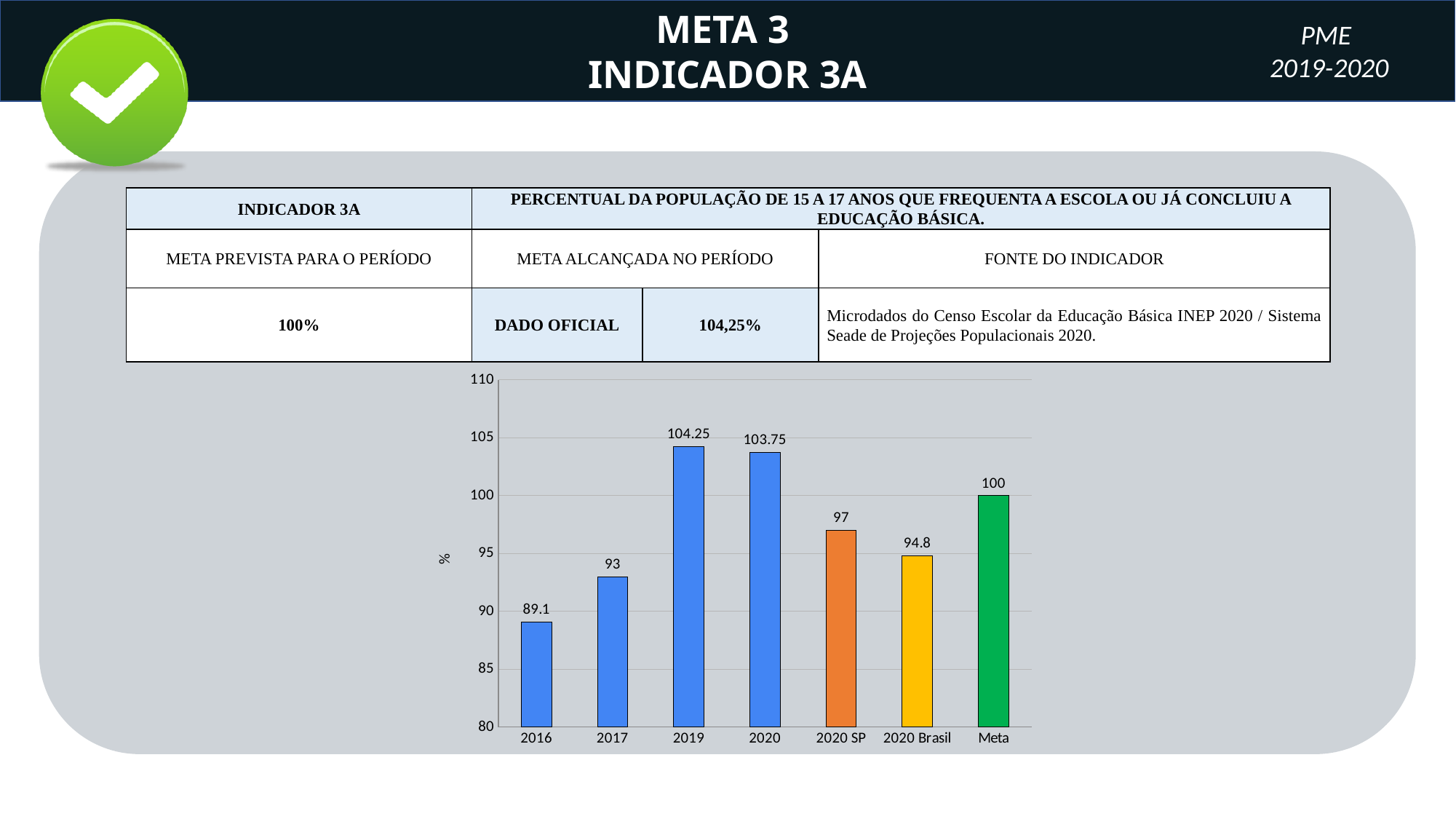
What is the value for 2019 in the bar chart? 104.25 How many bars are shown in the chart? 7 Which is larger, the value for 2020 or the value for 2020 SP? 2020 What is the difference between the values for 2020 SP and 2020 Brasil? 2.2 Which category has the lowest value in the bar chart? 2016 What is the value for Meta in the bar chart? 100 What is the label on the vertical axis of the chart? % What is the difference between the values for 2017 and 2016? 3.9 What is the value for 2020 Brasil in the bar chart? 94.8 Which category has the highest value in the bar chart? 2019 What kind of chart is shown on the slide? bar chart What is the value for 2016 in the bar chart? 89.1